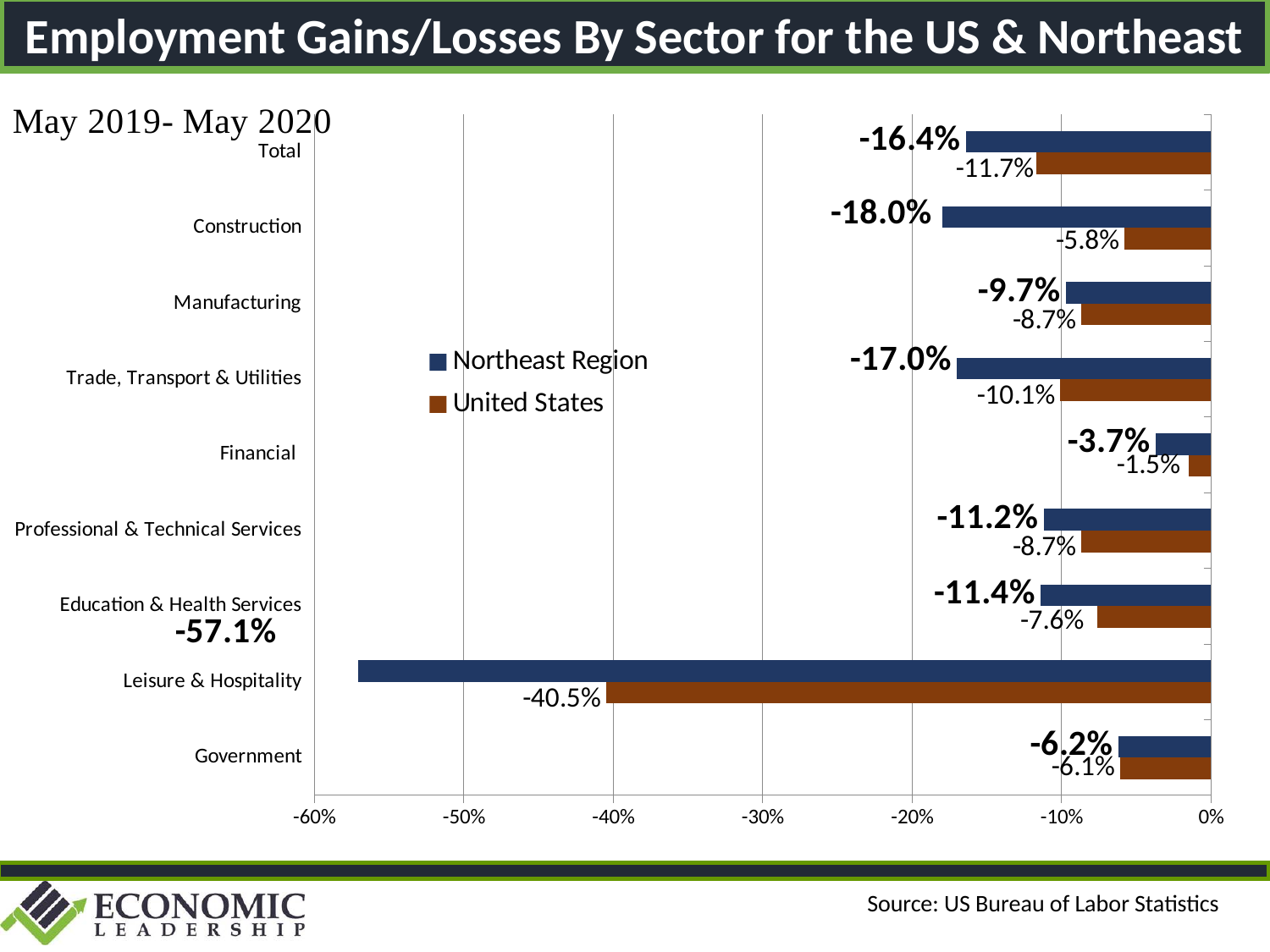
What is the Northeast Region value for Financial? -3.7% How many sectors (including Total) are shown on the chart? 9 How many percentage points larger is the Northeast Region decline than the United States decline for Leisure & Hospitality? 16.6 percentage points How many percentage points larger is the Northeast Region decline than the United States decline for Construction? 12.2 percentage points How many series does the legend list? 2 What is the United States value for Leisure & Hospitality? -40.5% Which sector shows the smallest employment decline for the United States? Financial What is the Northeast Region value for Construction? -18.0% Which sector shows the largest employment decline for the Northeast Region? Leisure & Hospitality What kind of chart is shown on the slide? Bar chart Which has the larger employment decline for Education & Health Services, the Northeast Region or the United States? Northeast Region What is the United States value for Trade, Transport & Utilities? -10.1%